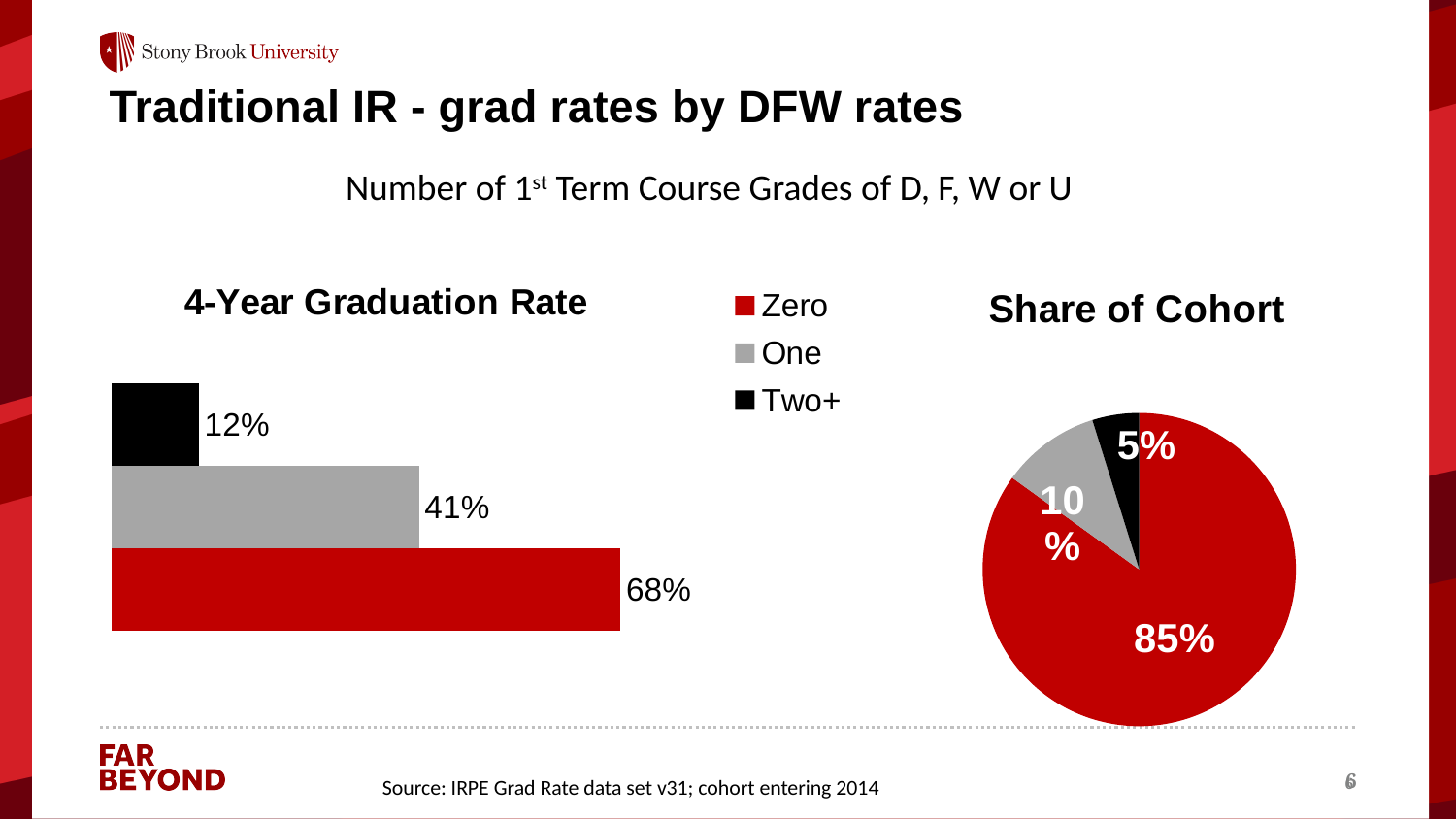
In the 4-Year Graduation Rate chart, which group has the highest graduation rate? Zero In the 4-Year Graduation Rate chart, what is the graduation rate for students with one DFW grade? 41% How many entries does the legend list? 3 In the Share of Cohort pie chart, what share of the cohort had zero DFW grades? 85% What colour represents the Zero group in the charts? Red In the 4-Year Graduation Rate chart, what is the graduation rate for students with two or more DFW grades? 12% In the 4-Year Graduation Rate chart, what is the difference between the graduation rates for the Zero and One groups? 27% In the Share of Cohort pie chart, what share of the cohort had two or more DFW grades? 5% What kind of chart is the 4-Year Graduation Rate chart? Bar chart In the Share of Cohort pie chart, which group is larger: One or Two+? One In the 4-Year Graduation Rate chart, which group has the lowest graduation rate? Two+ In the 4-Year Graduation Rate chart, what is the graduation rate for students with zero DFW grades? 68%